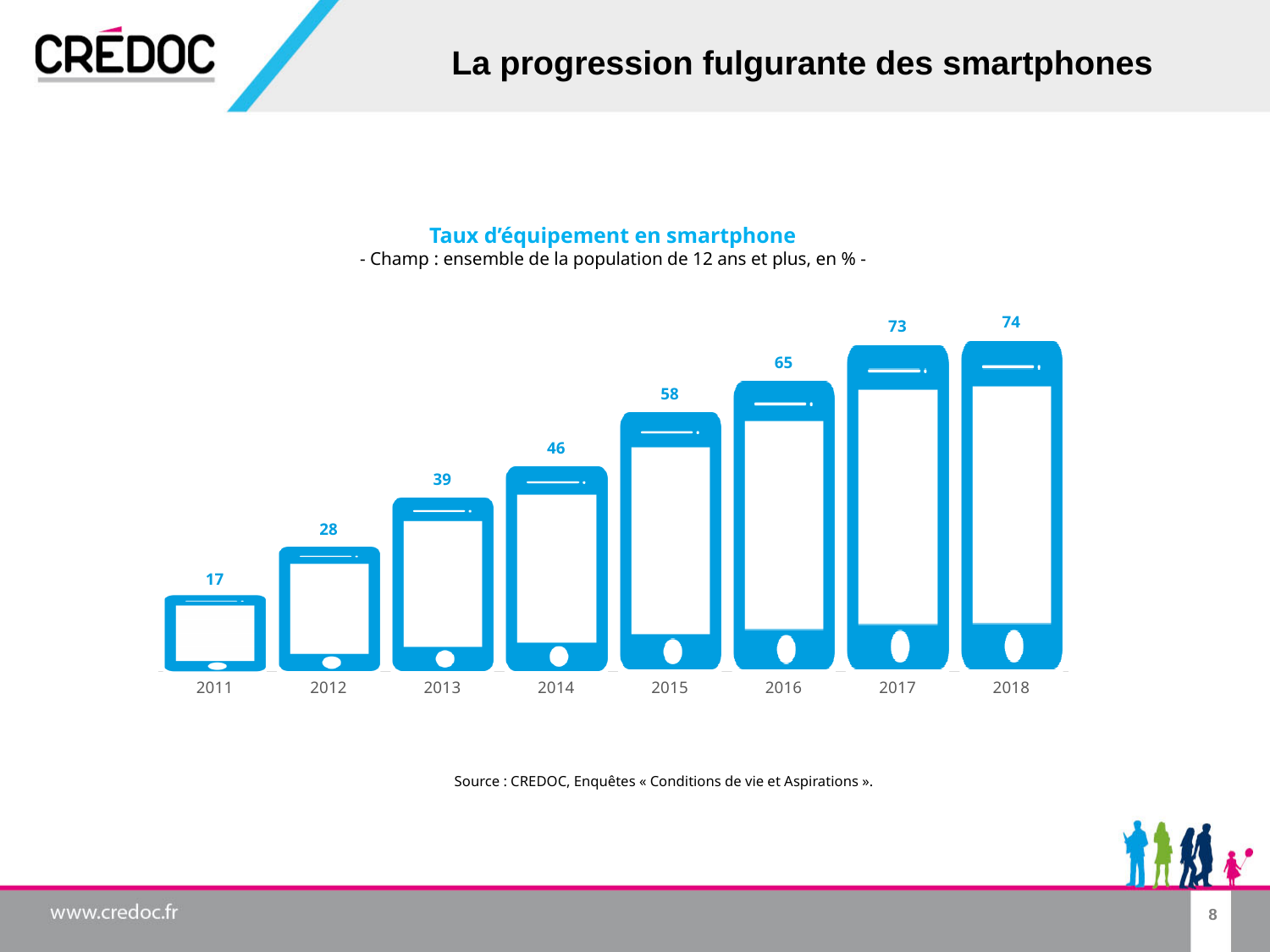
What kind of chart is this? bar chart Which year has the lowest value? 2011 What is the difference between the values for 2016 and 2015? 7 What is the difference between the values for 2018 and 2011? 57 How many years are shown on the x axis? 8 What is the smartphone equipment rate shown for 2014? 46 Which is larger, the value for 2013 or the value for 2012? 2013 Do the values rise or fall from 2011 to 2018? rise What value is shown for 2011? 17 What is the title of the chart? Taux d'équipement en smartphone Which year has the highest value? 2018 What value is shown for 2017? 73